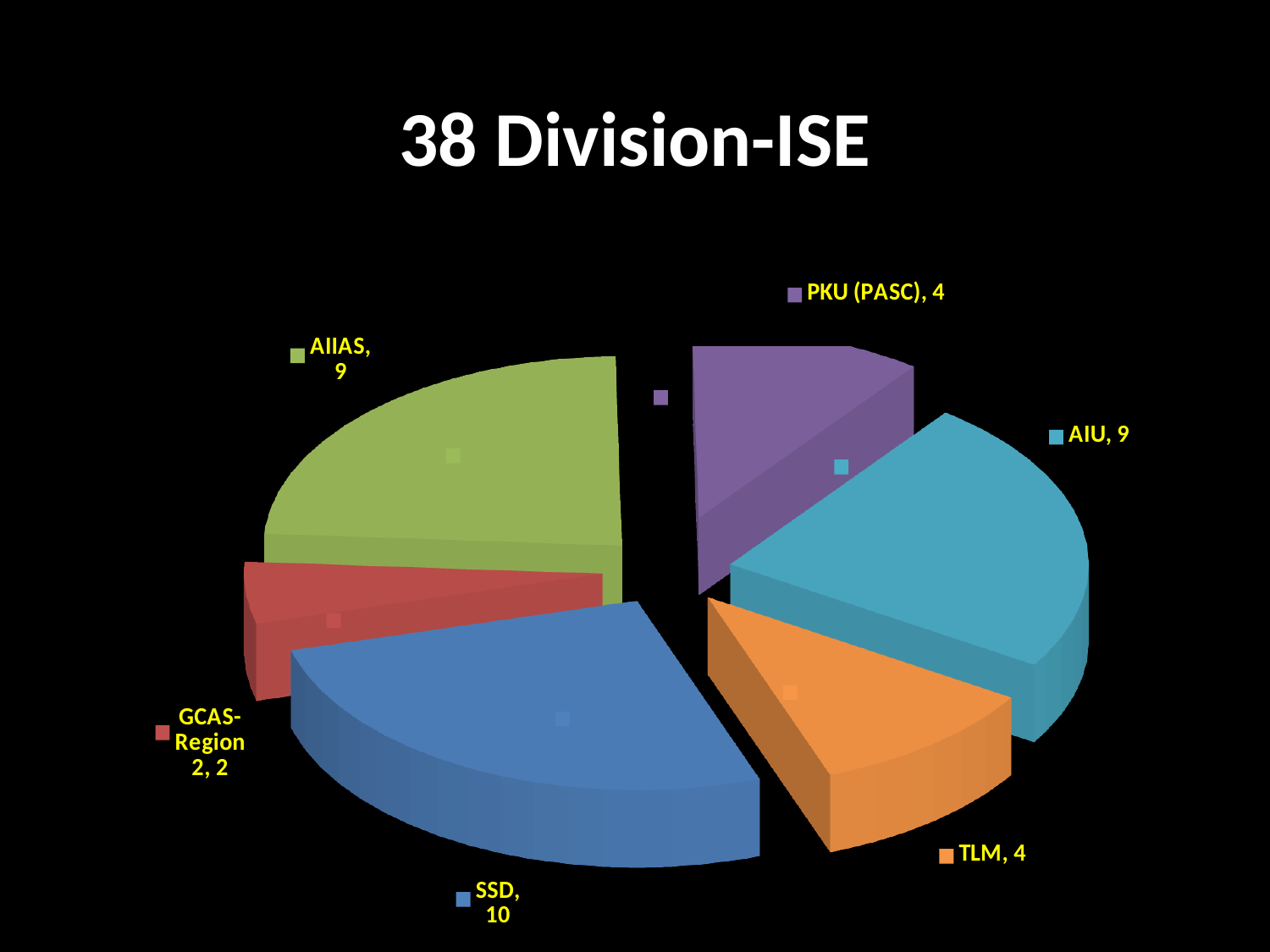
What is the total of all the slice values in the pie chart? 38 What is the value for GCAS-Region 2? 2 What is the value for SSD? 10 Which category has the largest slice? SSD How many slices does the pie chart have? 6 What is the difference between the values for SSD and TLM? 6 What is the value for PKU (PASC)? 4 What is the title of the chart? 38 Division-ISE What type of chart is shown on the slide? pie chart What is the value for AIU? 9 Which category has the smallest slice? GCAS-Region 2 Which is larger, the value for AIIAS or the value for TLM? AIIAS